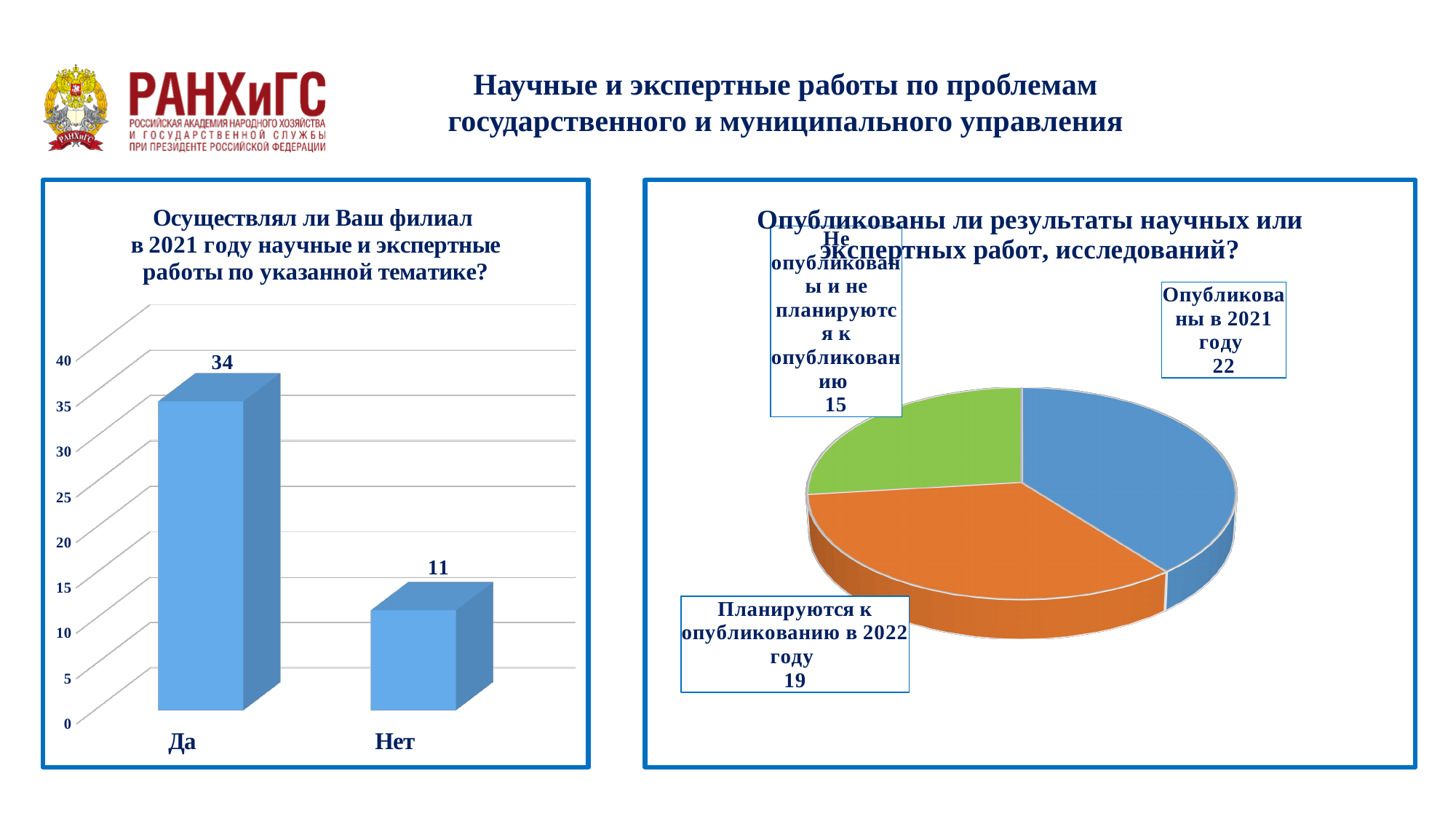
In the right pie chart, what is the value for "Не опубликованы и не планируются к опубликованию"? 15 In the left bar chart, how many categories are shown? 2 In the left bar chart, what is the value for "Нет"? 11 In the right pie chart, what is the total of all slices? 56 In the left bar chart, what is the difference between the values for "Да" and "Нет"? 23 In the left bar chart, which category has the higher value, "Да" or "Нет"? Да What kind of chart is shown on the left side of the slide? Bar chart What kind of chart is shown on the right side of the slide? Pie chart In the left bar chart, what is the value for "Да"? 34 In the right pie chart, which slice has the smallest value? Не опубликованы и не планируются к опубликованию In the right pie chart, what is the value for "Опубликованы в 2021 году"? 22 In the right pie chart, what is the value for "Планируются к опубликованию в 2022 году"? 19